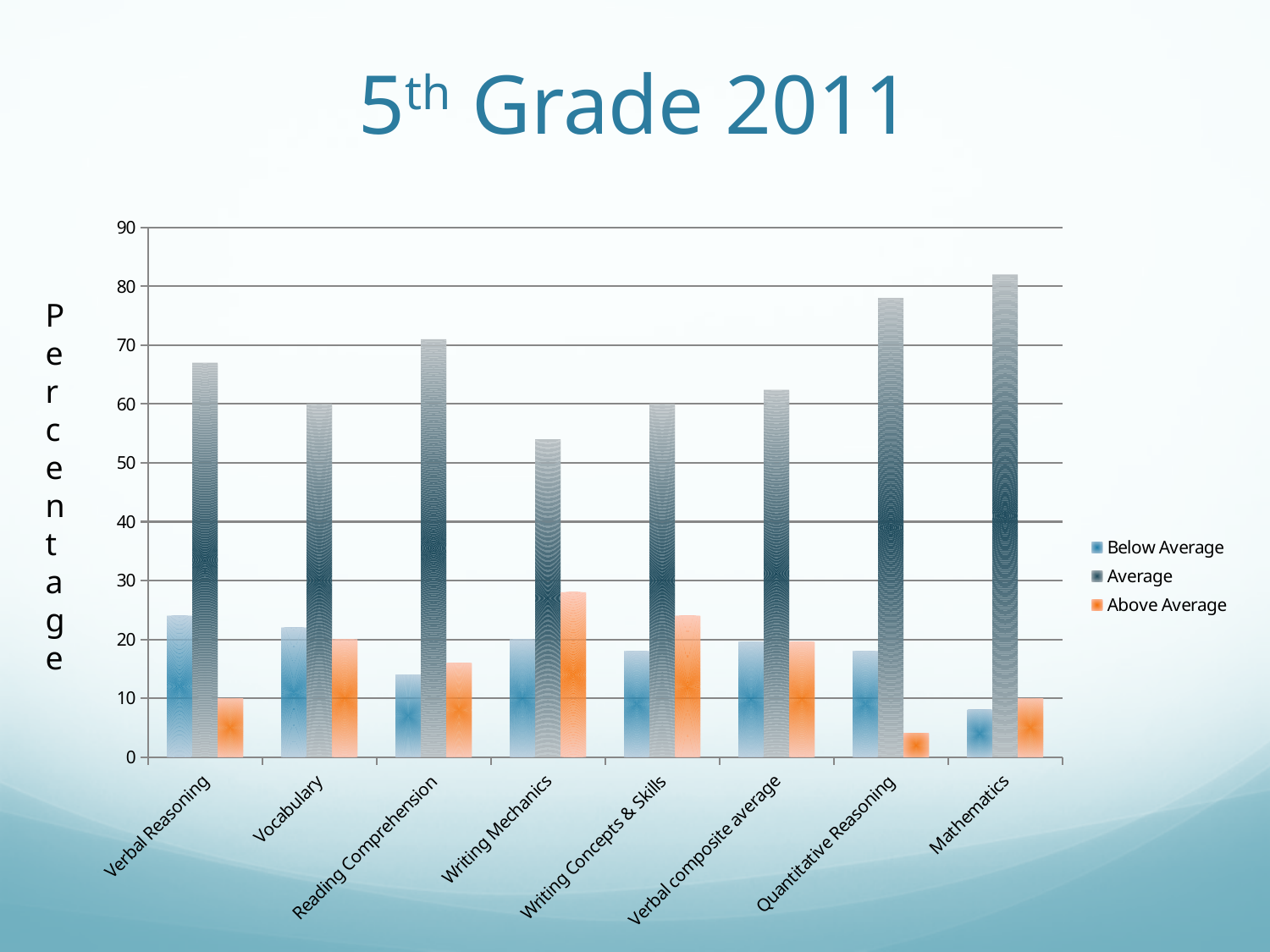
Which category has the highest Average value? Mathematics How many categories are shown along the x axis? 8 Is the Average value for Quantitative Reasoning greater or less than 70? greater For Writing Mechanics, which is larger: the Below Average value or the Above Average value? Above Average Which is larger: the Average value for Verbal Reasoning or the Average value for Reading Comprehension? Reading Comprehension Which category has the lowest Below Average value? Mathematics How many series does the legend list? 3 Is the Below Average value for Reading Comprehension greater or less than 20? less Is the Average value for Mathematics greater or less than 70? greater What is the title of the slide? 5th Grade 2011 Which category has the lowest Above Average value? Quantitative Reasoning What kind of chart is shown on the slide? bar chart